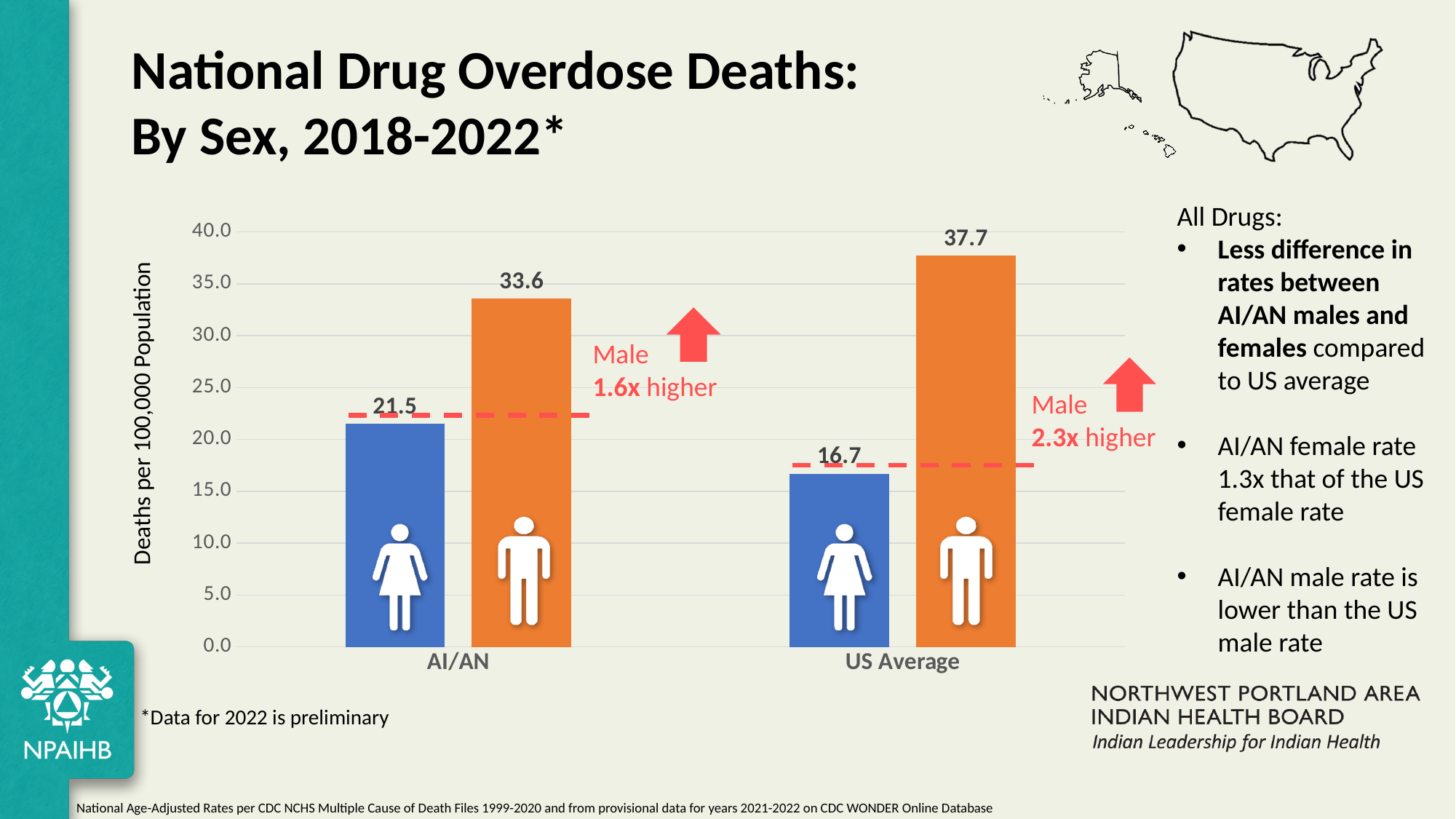
What is the difference between the US Average male rate and the US Average female rate? 21.0 How many category groups are shown on the x axis? 2 What is the drug overdose death rate for US Average males? 37.7 Which bar has the lowest value on the chart? US Average female (16.7) What is the difference between the AI/AN male rate and the AI/AN female rate? 12.1 What is the drug overdose death rate for AI/AN females? 21.5 What is the drug overdose death rate for AI/AN males? 33.6 What is the drug overdose death rate for US Average females? 16.7 Which is larger, the AI/AN male rate or the US Average male rate? US Average male rate What type of chart is shown on the slide? Bar chart Which bar has the highest value on the chart? US Average male (37.7) What is the y-axis label of the chart? Deaths per 100,000 Population